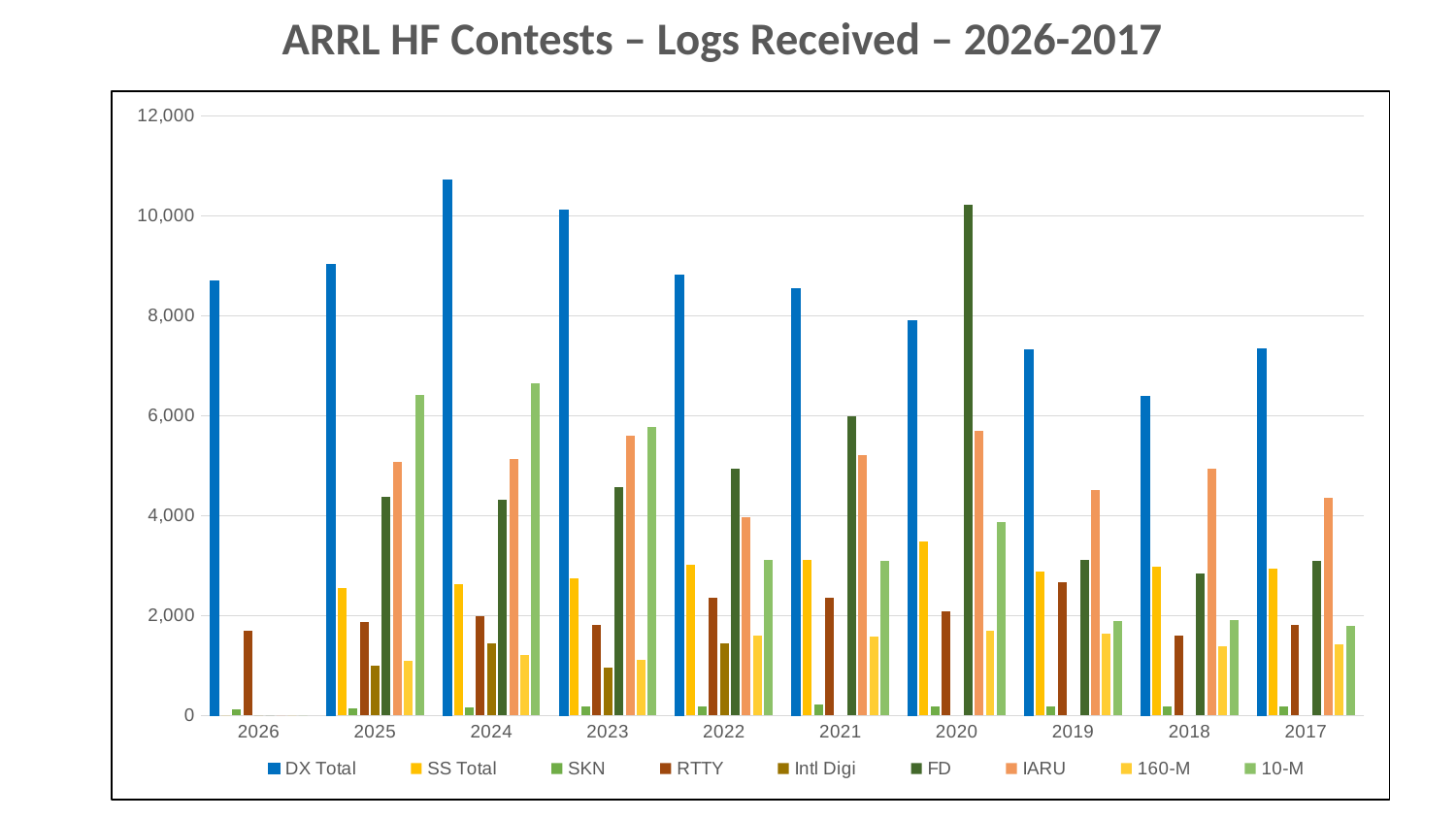
Is the DX Total value for 2026 greater or less than 8,000? greater In which year is the FD bar the highest? 2020 What is the title of the chart? ARRL HF Contests – Logs Received – 2026-2017 What kind of chart is shown on the slide? bar chart Is the 10-M value for 2024 greater or less than 6,000? greater How many series does the legend list? 9 In which year is the DX Total bar the highest? 2024 In 2020, which is larger, the FD bar or the DX Total bar? FD Is the IARU value for 2023 greater or less than 4,000? greater How many years are shown along the x axis? 10 Which is larger, the DX Total for 2025 or the DX Total for 2023? 2023 In which year is the DX Total bar the lowest? 2018